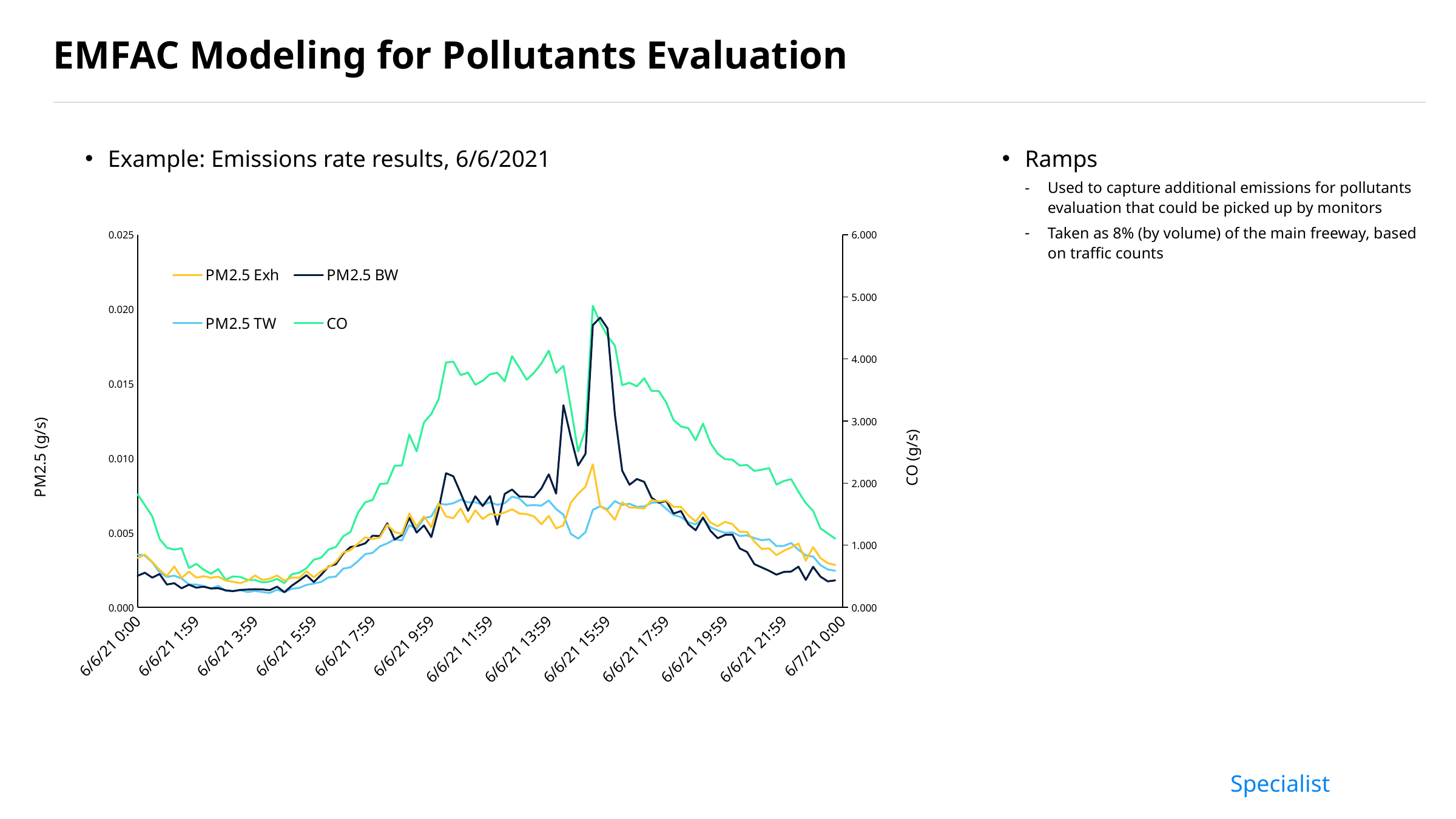
Is the peak value of the CO series greater or less than 4.000 on the right axis? greater Which series are listed in the chart's legend? PM2.5 Exh, PM2.5 BW, PM2.5 TW, CO What kind of chart is shown on the slide? line chart Is the value of PM2.5 BW at 6/6/21 0:00 greater or less than 0.005? less At around 6/6/21 15:59, which is larger: PM2.5 BW or PM2.5 Exh? PM2.5 BW Is the peak value of the PM2.5 BW series greater or less than 0.015 on the left axis? greater How many series does the chart's legend list? 4 How many time labels are shown along the x axis of the chart? 13 What is the label of the right-hand vertical axis of the chart? CO (g/s) Which of the PM2.5 series reaches the highest peak on the chart? PM2.5 BW Does the CO series rise or fall between 6/6/21 17:59 and 6/7/21 0:00? fall